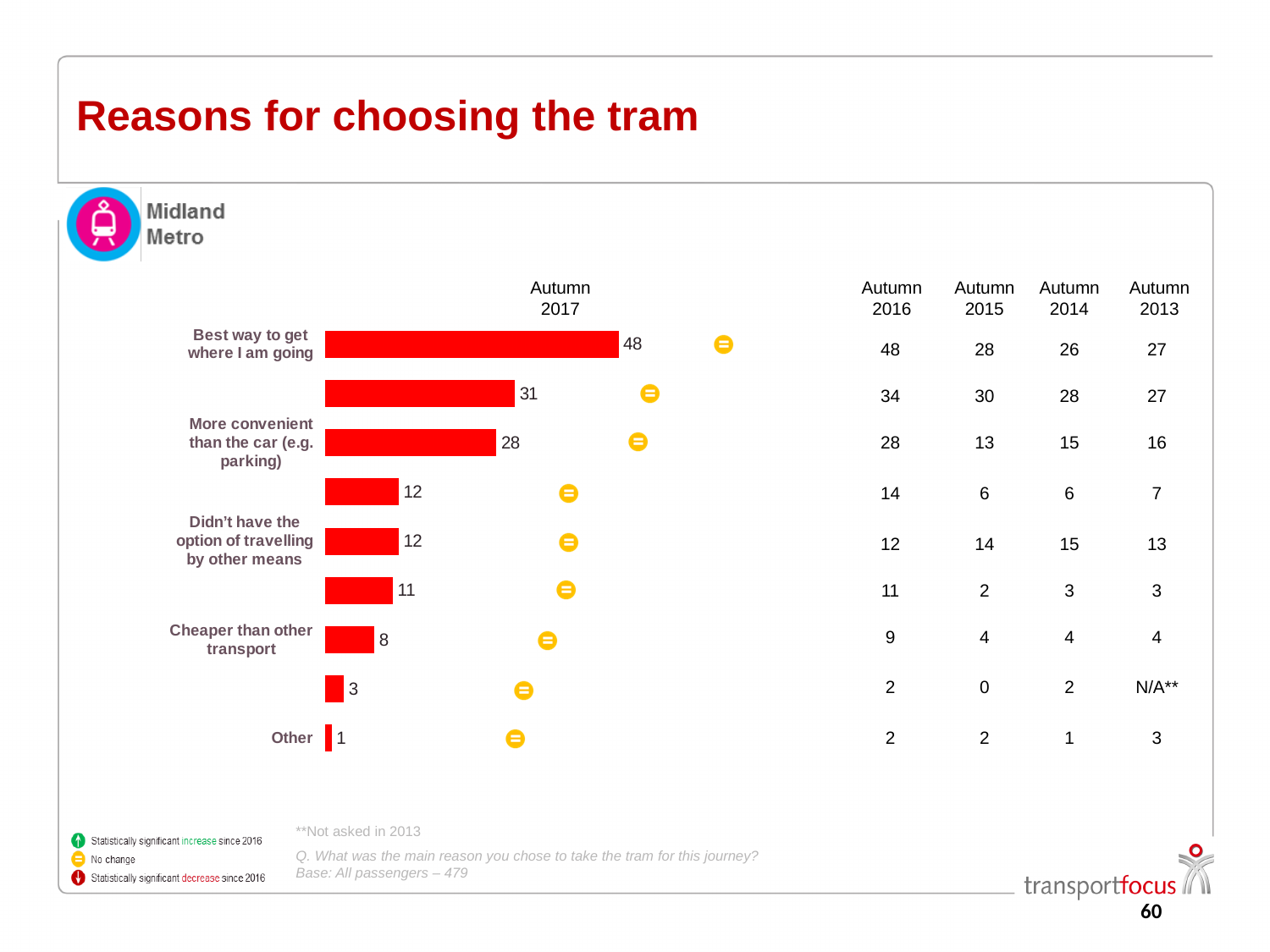
What is the Autumn 2017 value for "Didn't have the option of travelling by other means"? 12 How many bars are plotted in the Autumn 2017 chart? 9 What is the Autumn 2017 value for "Cheaper than other transport"? 8 Which reason has the lowest Autumn 2017 value? Other What is the Autumn 2017 value for "Best way to get where I am going"? 48 Which has the larger Autumn 2017 value: "Cheaper than other transport" or "Didn't have the option of travelling by other means"? Didn't have the option of travelling by other means What kind of chart is shown on the slide? Bar chart What is the Autumn 2017 value for "Other"? 1 What is the title of the slide containing the chart? Reasons for choosing the tram Which reason has the highest Autumn 2017 value? Best way to get where I am going What is the Autumn 2017 value for "More convenient than the car (e.g. parking)"? 28 What is the difference between the Autumn 2017 values for "Best way to get where I am going" and "More convenient than the car (e.g. parking)"? 20